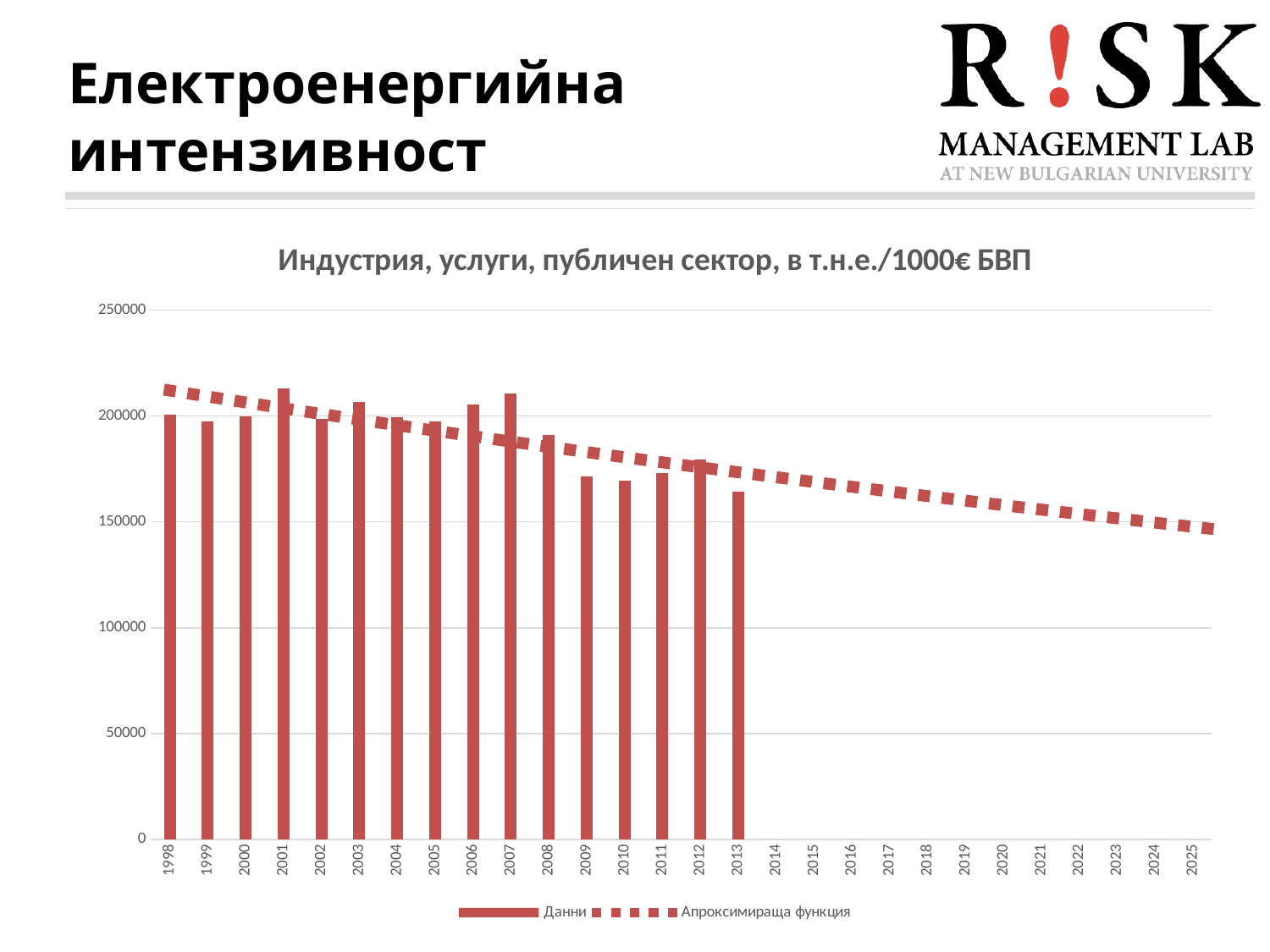
How many series does the legend list? 2 What are the two entries in the chart legend? Данни, Апроксимираща функция Do the values of the approximating function rise or fall along the x axis? fall What is the title of the chart? Индустрия, услуги, публичен сектор, в т.н.е./1000€ БВП Which is the last year with a data bar on the x axis? 2013 Is the value for 2013 greater or less than 200000? less Is the value for 1998 greater or less than 150000? greater Is the value for 2009 greater or less than 200000? less Which is the first year with a data bar on the x axis? 1998 What kind of chart is shown on the slide? bar chart How many years have a data bar plotted in the chart? 16 Which is larger, the value for 2001 or the value for 2013? 2001